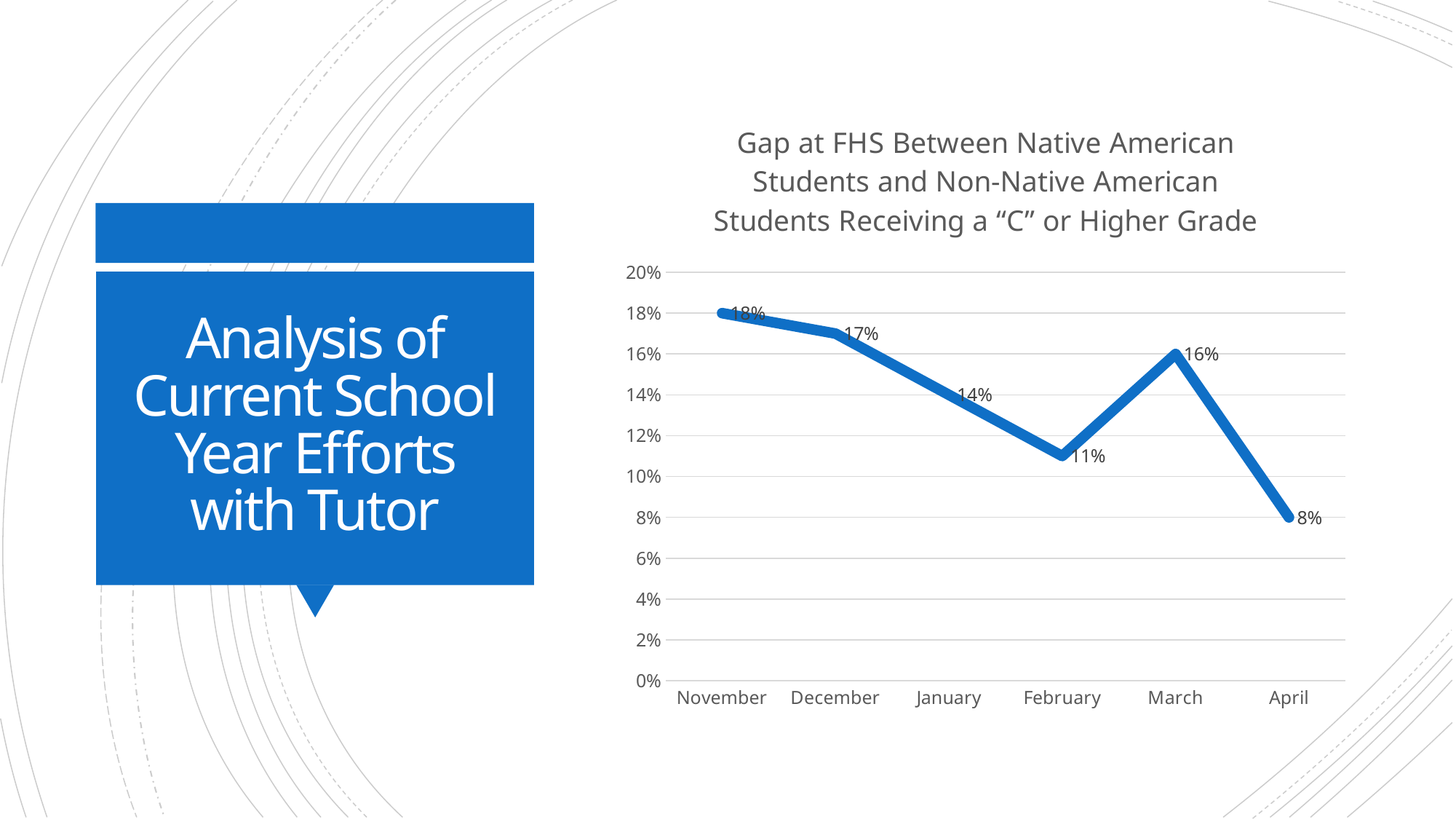
What is the gap value for February? 11% Which month has a larger gap value, December or January? December Which month has the highest gap value? November How many months are plotted on the chart? 6 Which month has the lowest gap value? April What kind of chart is shown on the slide? Line chart What is the gap value for November? 18% What is the gap value for April? 8% What is the gap value for March? 16% What is the difference between the gap values for November and April? 10% Does the gap value rise or fall from November to February? Fall What is the difference between the gap values for March and February? 5%